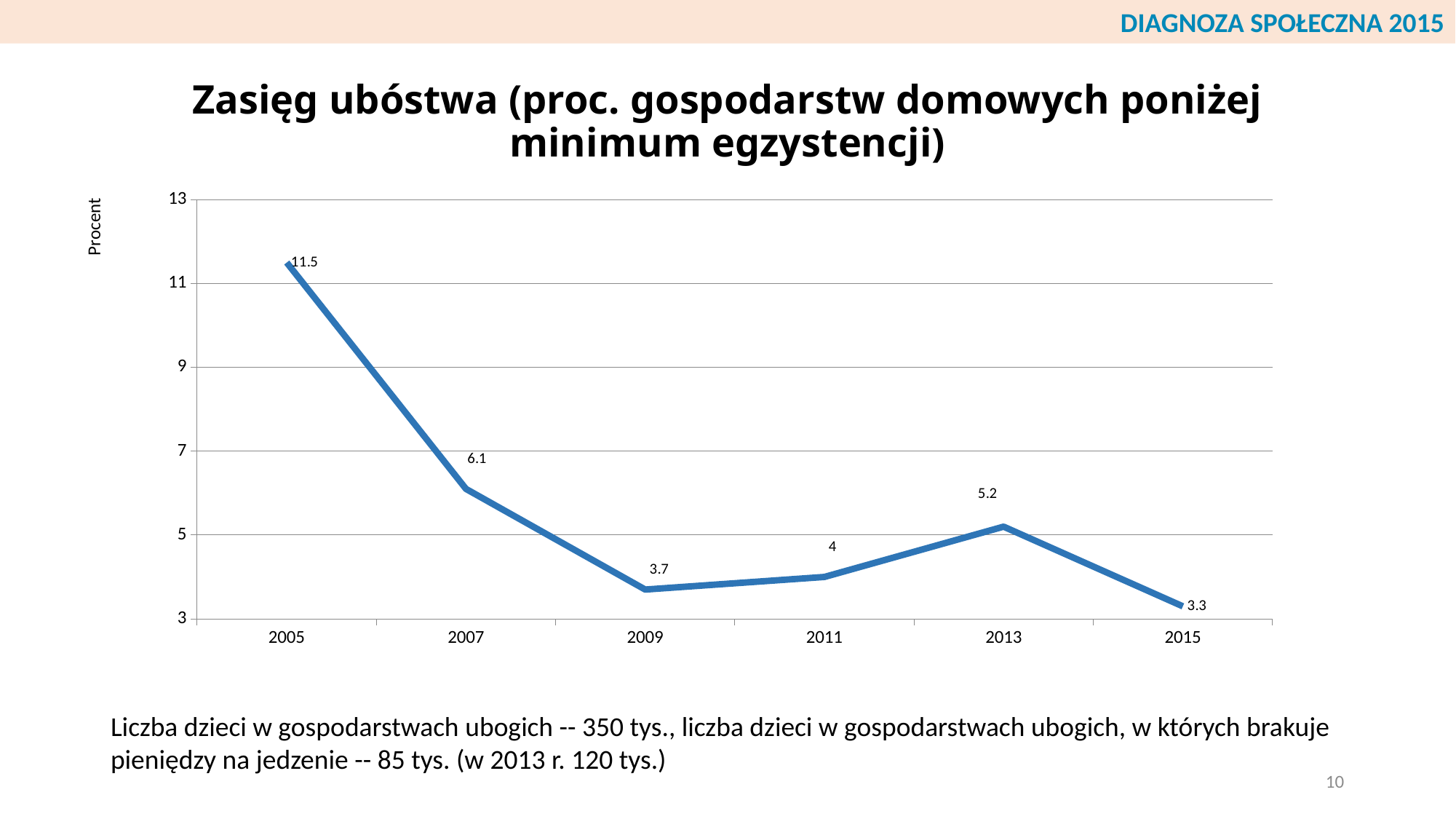
How many data points are plotted on the chart? 6 What is the value for 2005? 11.5 What is the label of the vertical axis? Procent What is the value for 2015? 3.3 What is the difference between the values for 2013 and 2011? 1.2 Which year has the highest value? 2005 What is the difference between the values for 2005 and 2007? 5.4 What is the value for 2009? 3.7 Which is larger, the value for 2011 or the value for 2013? 2013 What kind of chart is shown on the slide? line chart Which year has the lowest value? 2015 What is the value for 2013? 5.2